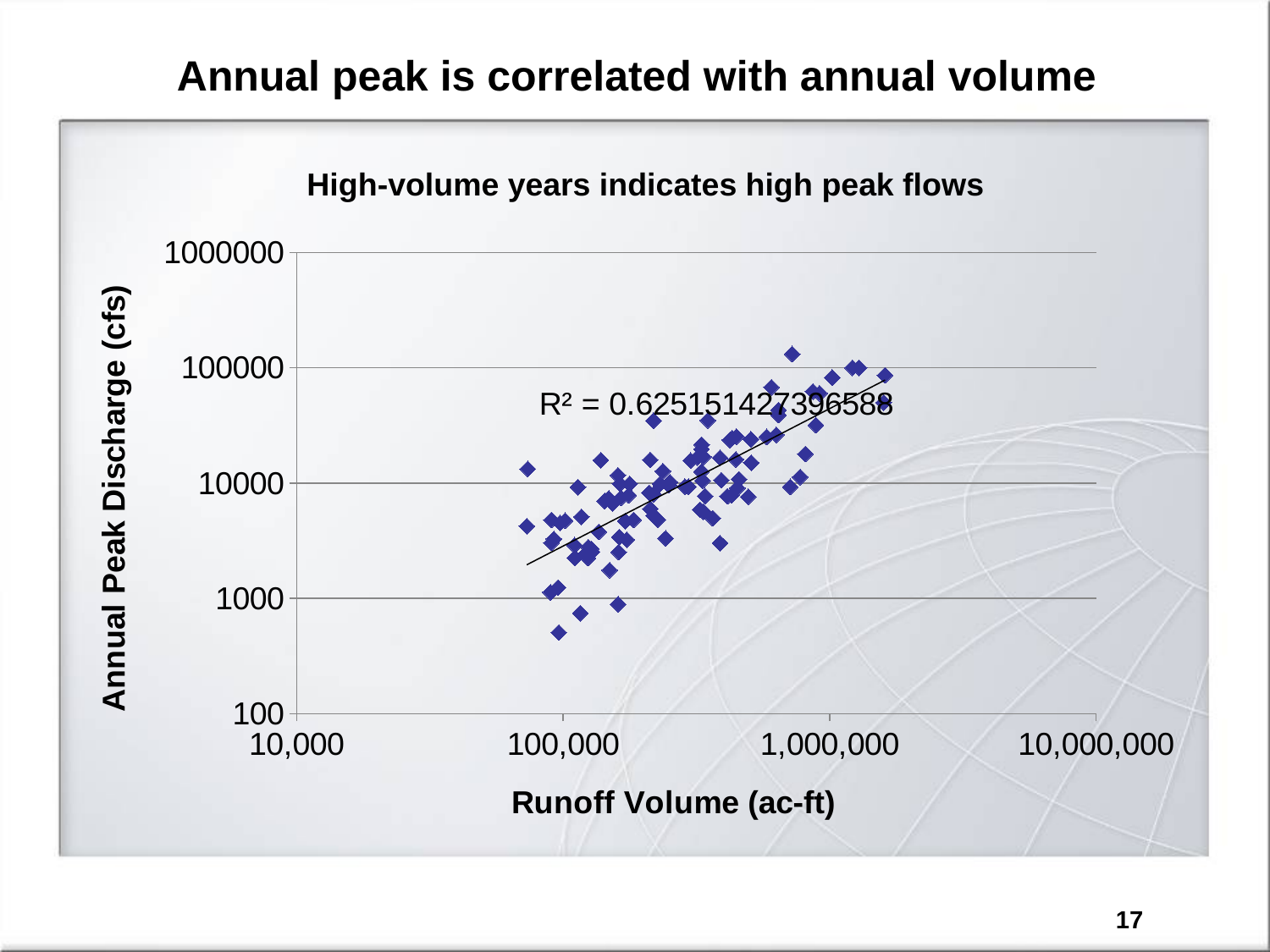
Is the lowest plotted point on the chart greater or less than 1000 cfs? less Does annual peak discharge rise or fall as runoff volume increases along the x axis? Rise How many series of points are plotted on the chart? 1 What is the label of the x axis of the chart? Runoff Volume (ac-ft) Are all plotted points at a runoff volume greater or less than 10,000,000 ac-ft? less Does the trendline on the chart slope upward or downward from left to right? Upward What is the title of the chart? High-volume years indicates high peak flows What R² value is printed on the chart? R² = 0.625151427396588 Is the highest plotted point on the chart greater or less than 100000 cfs? greater What kind of chart is shown on the slide? Scatter chart